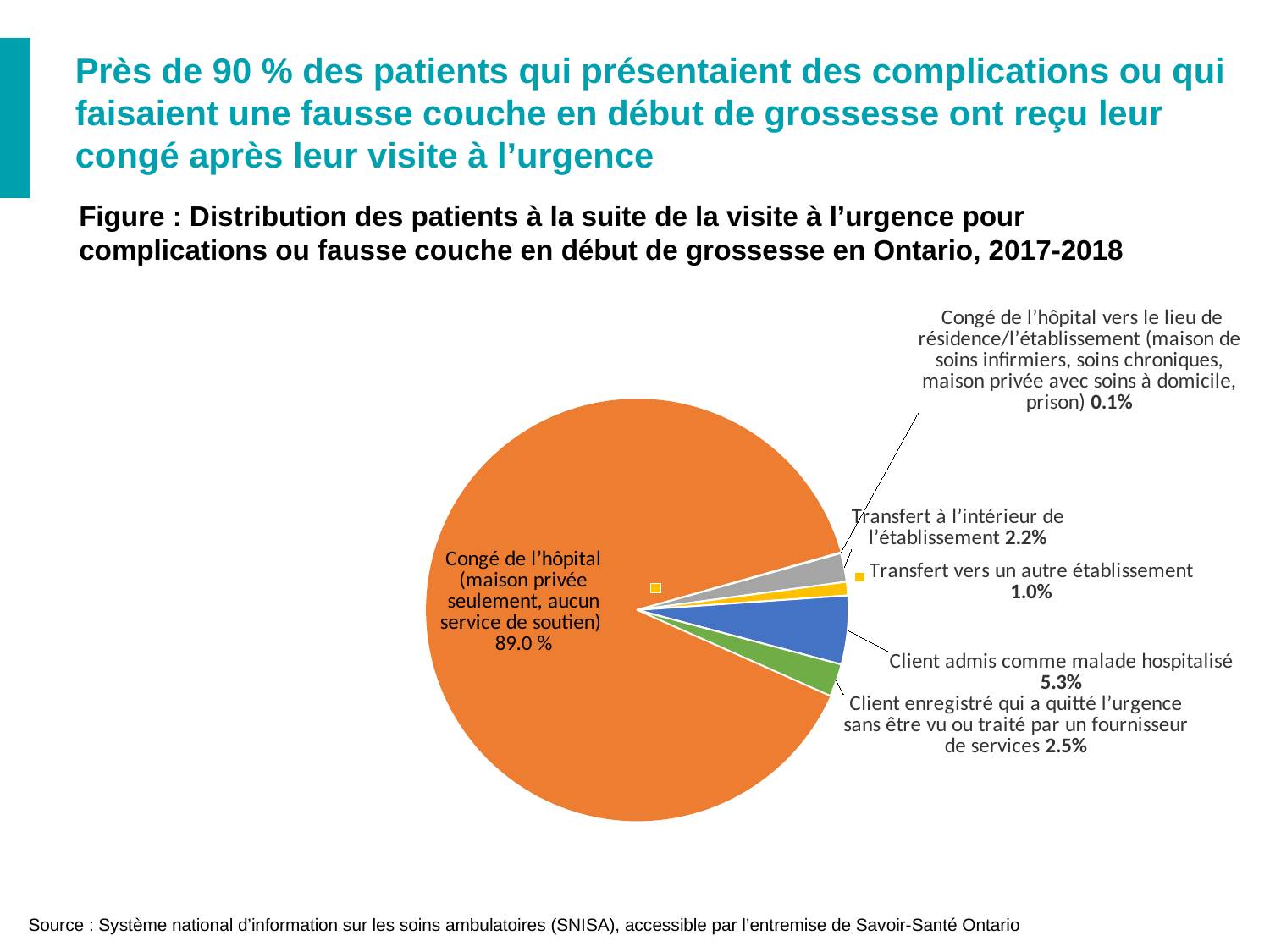
What is the value for "Transfert vers un autre établissement"? 1.0% What share of patients received "Congé de l'hôpital (maison privée seulement, aucun service de soutien)"? 89.0 % What colour is the largest slice of the pie chart? orange What is the difference in percentage points between "Client admis comme malade hospitalisé" and "Client enregistré qui a quitté l'urgence sans être vu ou traité par un fournisseur de services"? 2.8 Which category has the largest share of the pie? Congé de l'hôpital (maison privée seulement, aucun service de soutien) Which category has the smallest share of the pie? Congé de l'hôpital vers le lieu de résidence/l'établissement (maison de soins infirmiers, soins chroniques, maison privée avec soins à domicile, prison) What percentage of patients left the emergency department without being seen or treated by a service provider? 2.5% What is the value for "Transfert à l'intérieur de l'établissement"? 2.2% How many slices does the pie chart have? 6 What type of chart is shown on the slide? pie chart What percentage of patients were "Client admis comme malade hospitalisé"? 5.3% Which is larger: the share for "Transfert à l'intérieur de l'établissement" or the share for "Transfert vers un autre établissement"? Transfert à l'intérieur de l'établissement